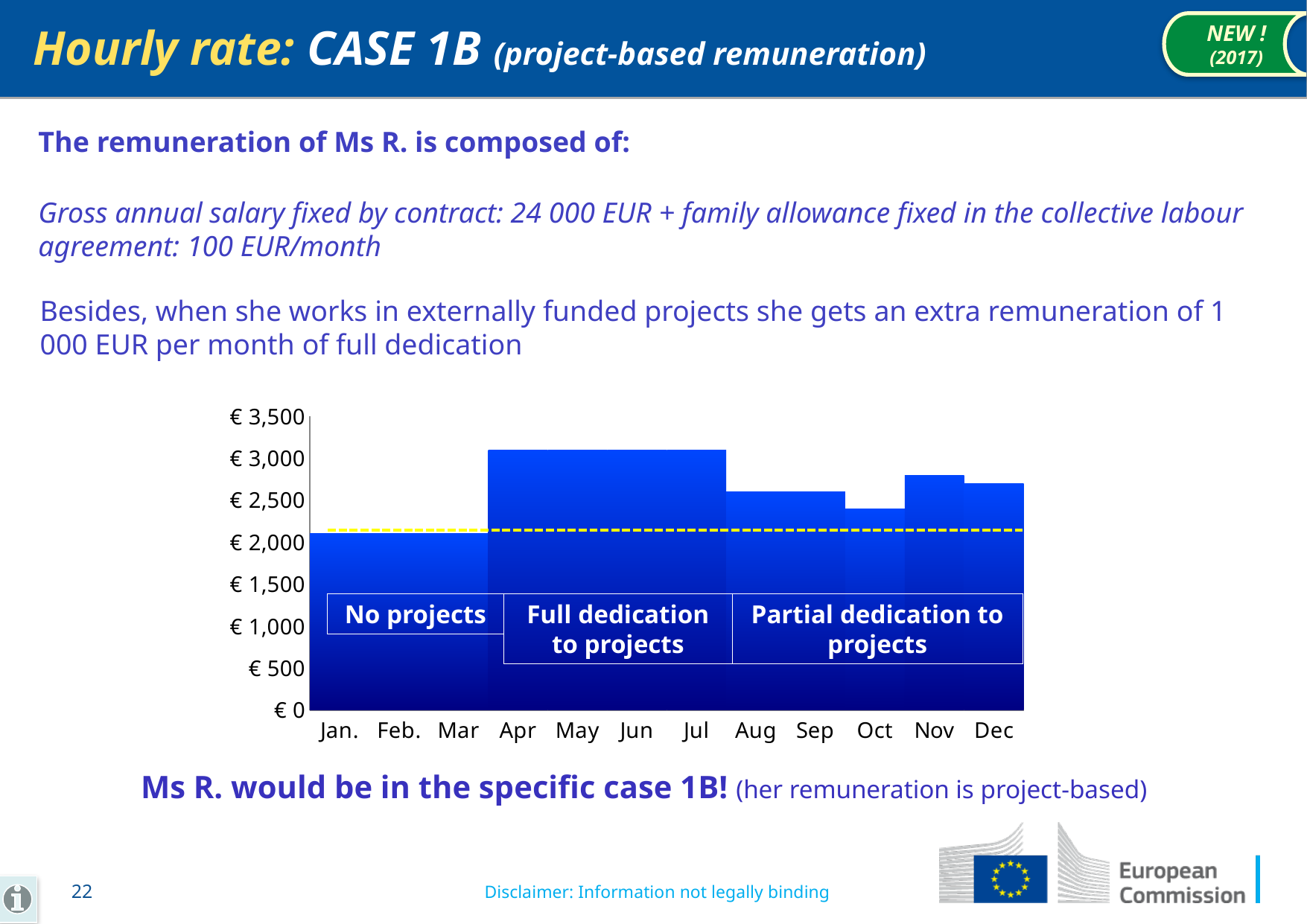
Which is larger, the value for Jun or the value for Feb.? Jun Do the values rise or fall from Mar to Apr? rise What kind of chart is shown on the slide? bar chart Is the value for Mar greater or less than € 3,000? less How many months are shown along the x axis of the chart? 12 What label is shown over the Jan. to Mar bars in the chart? No projects Is the value for Apr greater or less than € 2,500? greater Is the value for Nov greater or less than € 2,500? greater Which is larger, the value for Jul or the value for Dec? Jul What label is shown over the Aug to Dec bars in the chart? Partial dedication to projects